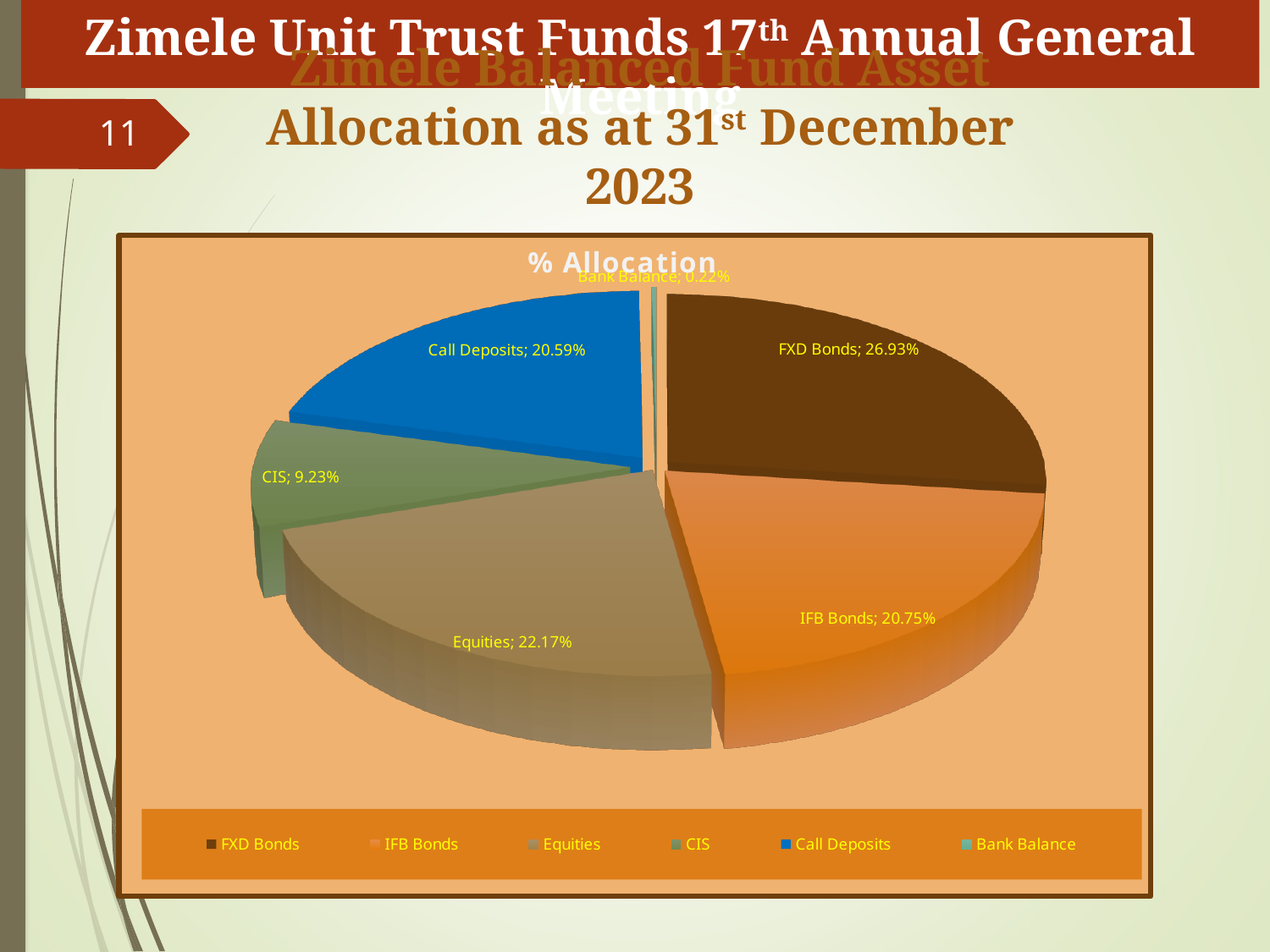
Which category has the smallest share of the pie? Bank Balance Which is larger, Equities or CIS? Equities What percentage of the allocation is FXD Bonds? 26.93% What kind of chart is shown on the slide? Pie chart Which category has the largest share of the pie? FXD Bonds What is the value shown for Call Deposits? 20.59% What colour is the Call Deposits slice? Blue What is the value shown for Bank Balance? 0.22% How many categories does the legend list? 6 What is the value shown for Equities? 22.17% What is the difference between the FXD Bonds and IFB Bonds percentages? 6.18% What is the chart's title? % Allocation